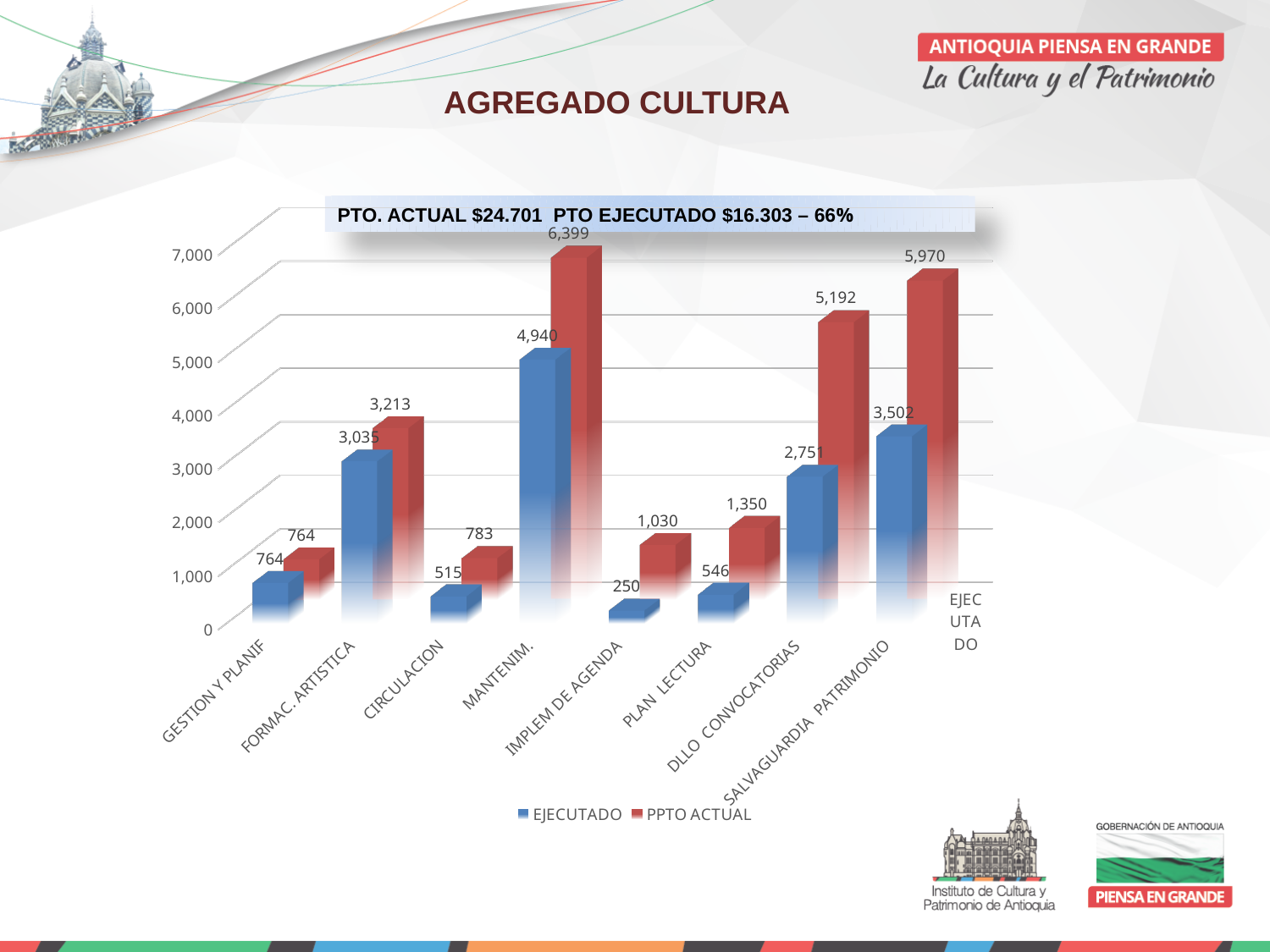
How many categories are shown on the x axis of the chart? 8 Which is larger for PLAN LECTURA, the EJECUTADO value or the PPTO ACTUAL value? PPTO ACTUAL What is the EJECUTADO value for IMPLEM DE AGENDA? 250 Which category has the lowest EJECUTADO value? IMPLEM DE AGENDA What kind of chart is shown on the slide? Bar chart Which category has the highest PPTO ACTUAL value? MANTENIM. What is the EJECUTADO value for MANTENIM.? 4,940 What is the difference between the PPTO ACTUAL and EJECUTADO values for SALVAGUARDIA PATRIMONIO? 2,468 What colour are the PPTO ACTUAL bars? Red How many series does the legend list? 2 What is the PPTO ACTUAL value for CIRCULACION? 783 What is the PPTO ACTUAL value for DLLO CONVOCATORIAS? 5,192